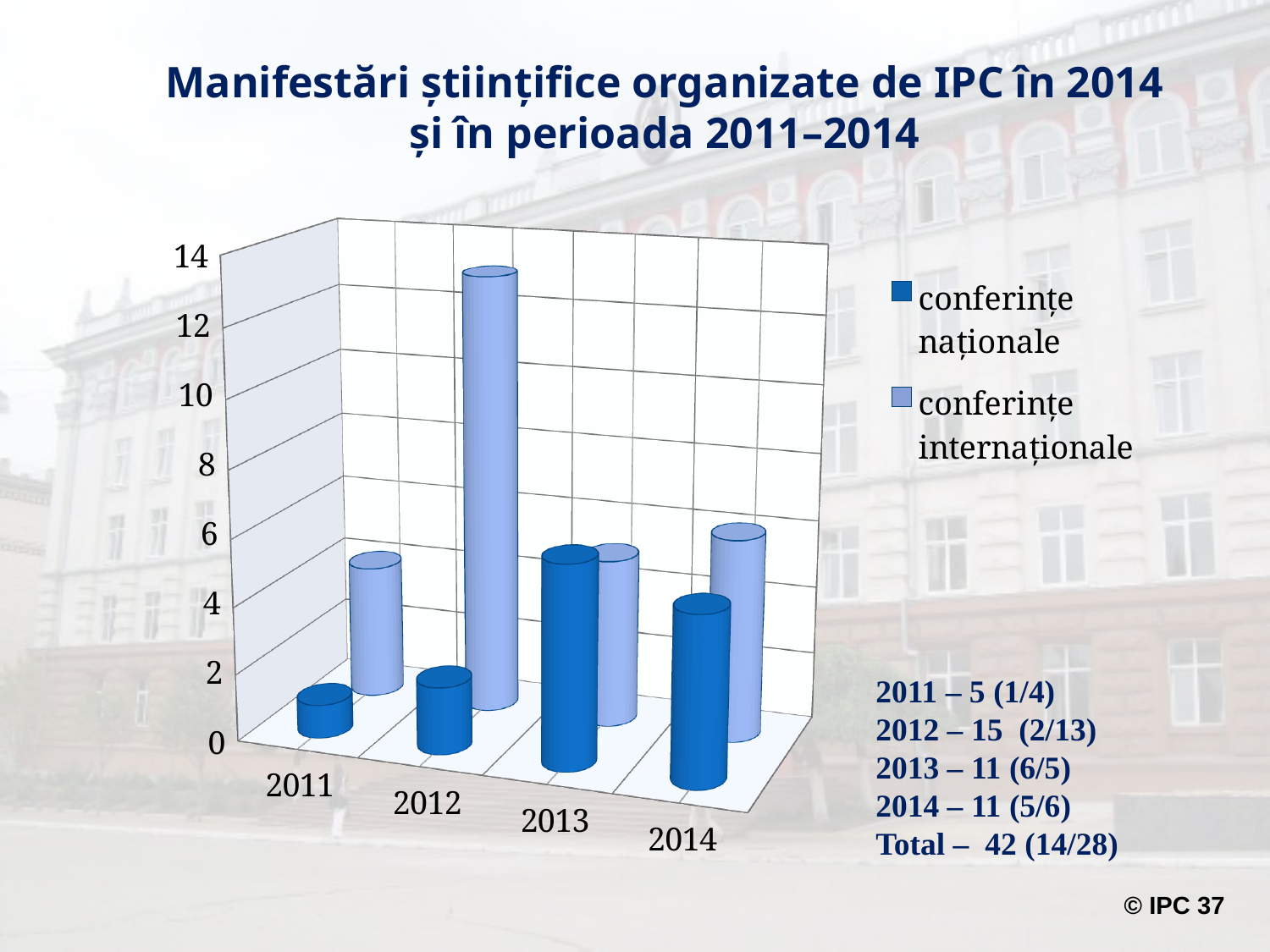
What is the difference between conferințe internaționale and conferințe naționale in 2012? 11 According to the slide, how many conferințe naționale were organized in 2013? 6 How many series does the chart legend list? 2 What is the total number of scientific events listed on the slide for 2011–2014? 42 Is the value for conferințe internaționale in 2012 greater or less than 12? greater What kind of chart is shown on the slide? bar chart According to the slide, how many conferințe naționale were organized in 2011? 1 Which is larger in 2013: conferințe naționale or conferințe internaționale? conferințe naționale In which year is the conferințe internaționale bar the highest? 2012 According to the slide, how many conferințe internaționale were organized in 2012? 13 In which year is the conferințe naționale bar the lowest? 2011 How many years are shown on the x axis of the chart? 4